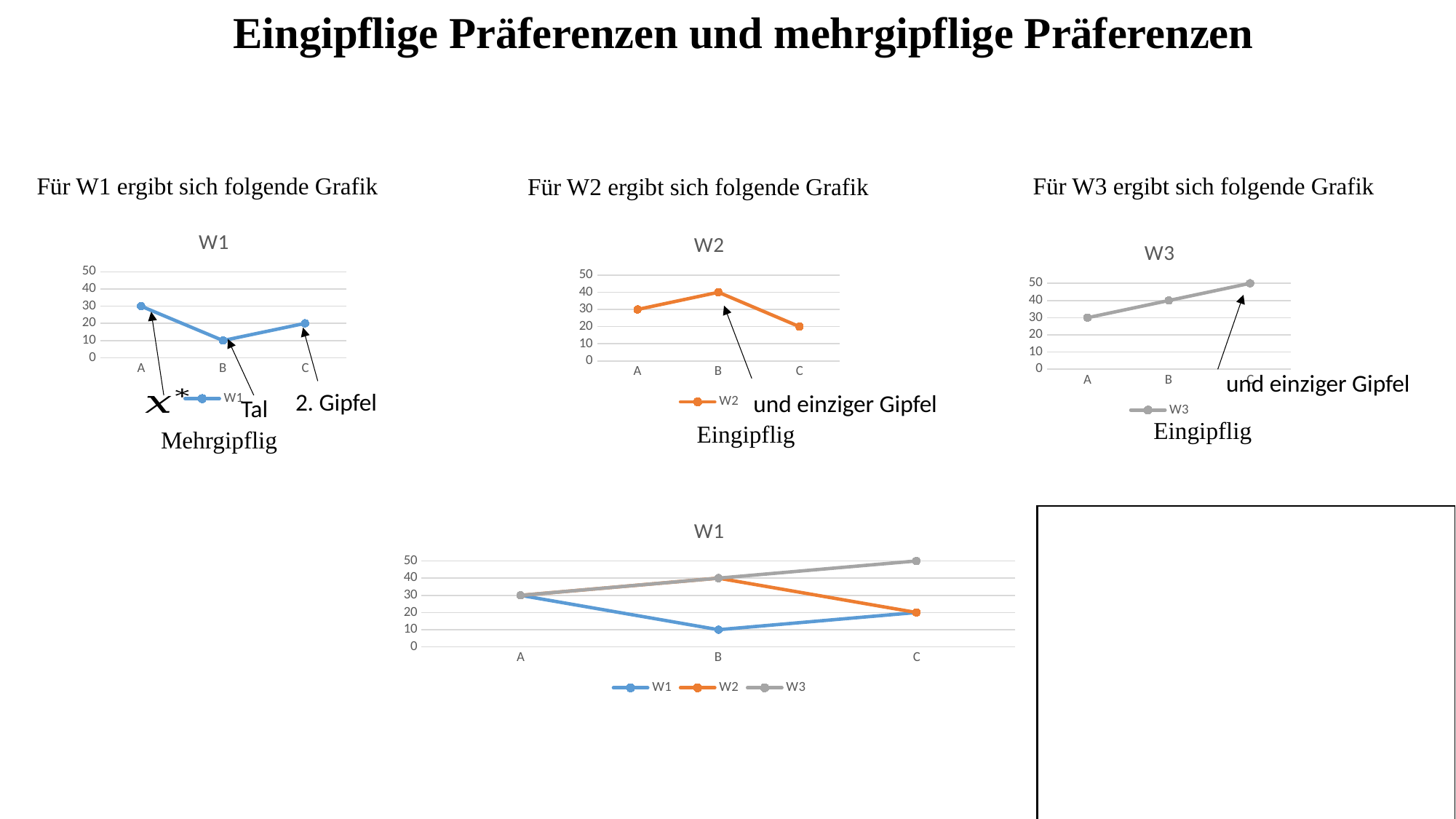
In the top-right chart titled W3, do the values rise or fall from A to C? rise What kind of chart is the top-right chart titled W3? line chart In the top-left chart titled W1, what is the difference between the values at A and B? 20 In the top-left chart titled W1, what is the value at B? 10 How many categories are shown on the x axis of the bottom chart? 3 In the bottom chart, how many series does the legend list? 3 In the top-middle chart titled W2, which category has the highest value? B In the top-right chart titled W3, what is the value at C? 50 In the top-left chart titled W1, which category has the lowest value? B In the bottom chart, what is the value of the W2 series at C? 20 In the bottom chart, which series has the higher value at C, W1 or W3? W3 In the top-middle chart titled W2, what is the value at B? 40